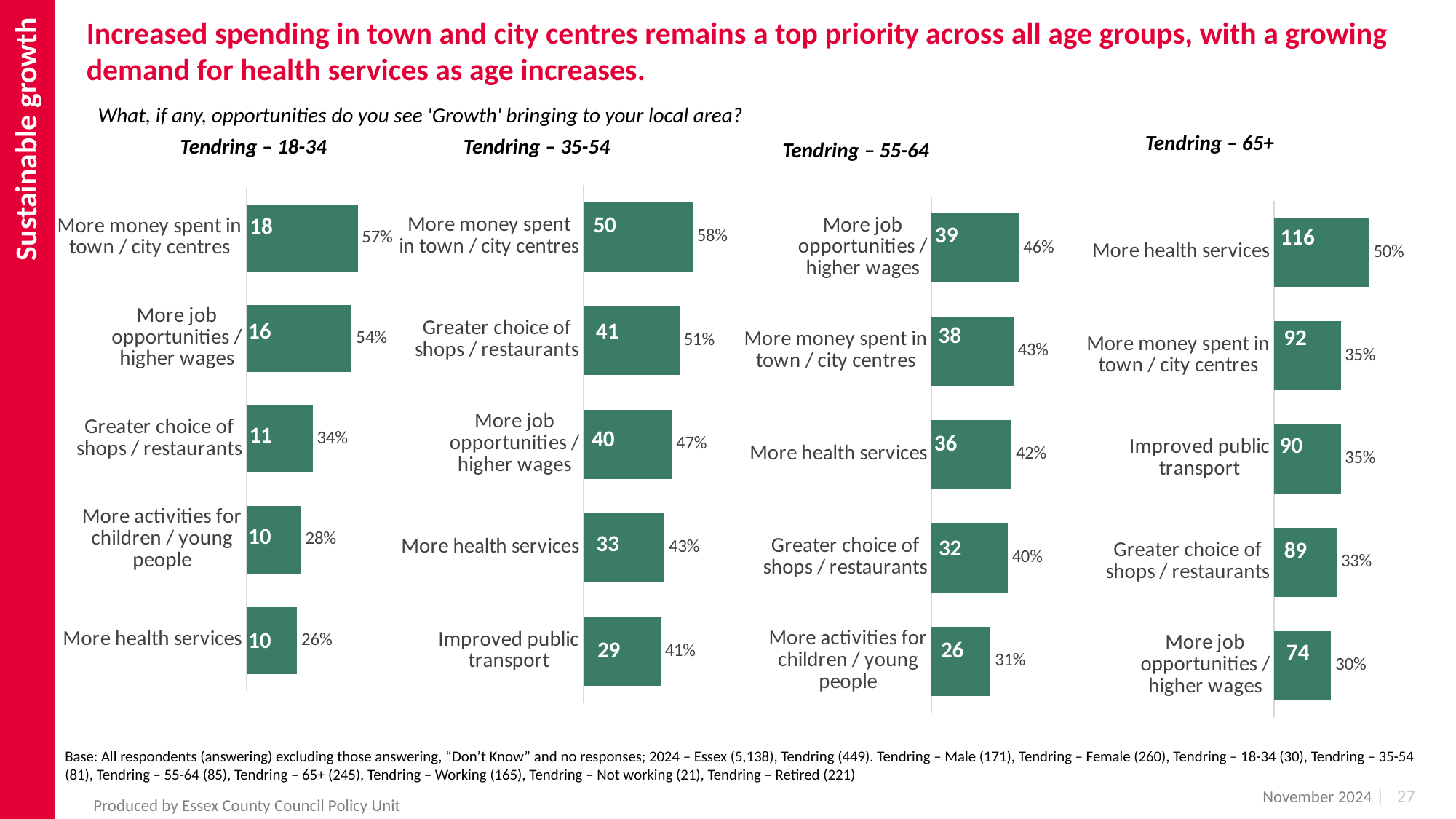
In the Tendring – 65+ chart, what is the count for 'More health services'? 116 In the Tendring – 18-34 chart, what percentage is shown for 'Greater choice of shops / restaurants'? 34% In the Tendring – 55-64 chart, what is the difference in count between 'More job opportunities / higher wages' and 'More activities for children / young people'? 13 How many categories are shown in the Tendring – 65+ chart? 5 In the Tendring – 35-54 chart, which category has the highest value? More money spent in town / city centres In the Tendring – 18-34 chart, what is the count for 'More money spent in town / city centres'? 18 How many charts are shown on the slide? 4 In the Tendring – 35-54 chart, what is the difference in count between 'Greater choice of shops / restaurants' and 'Improved public transport'? 12 In the Tendring – 55-64 chart, which category has the lowest value? More activities for children / young people What type of chart is used for the Tendring – 18-34 data? Bar chart In the Tendring – 65+ chart, which is larger: 'Improved public transport' or 'More job opportunities / higher wages'? Improved public transport In the Tendring – 35-54 chart, what percentage is shown for 'More health services'? 43%